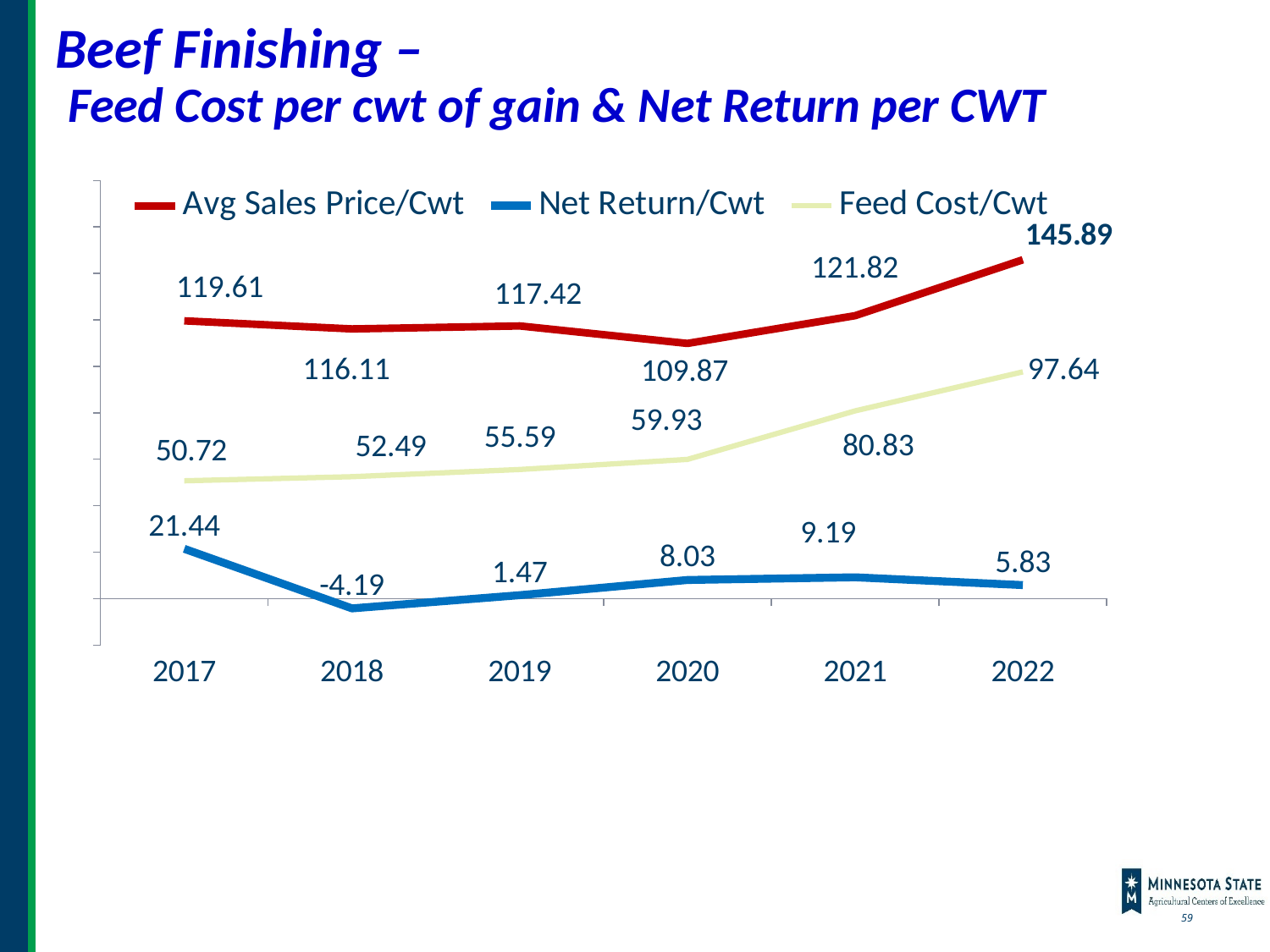
What kind of chart is shown on the slide? Line chart In which year is Feed Cost/Cwt highest? 2022 How many series does the legend list? 3 What is the Feed Cost/Cwt value for 2020? 59.93 Which is larger, Net Return/Cwt in 2017 or in 2021? 2017 What is the difference between Feed Cost/Cwt in 2022 and in 2021? 16.81 What is the Avg Sales Price/Cwt value for 2022? 145.89 In which year is Net Return/Cwt lowest? 2018 Does Feed Cost/Cwt rise or fall from 2017 to 2022? Rise What is the Net Return/Cwt value for 2018? -4.19 In which year is Avg Sales Price/Cwt lowest? 2020 How many years are shown on the x axis? 6